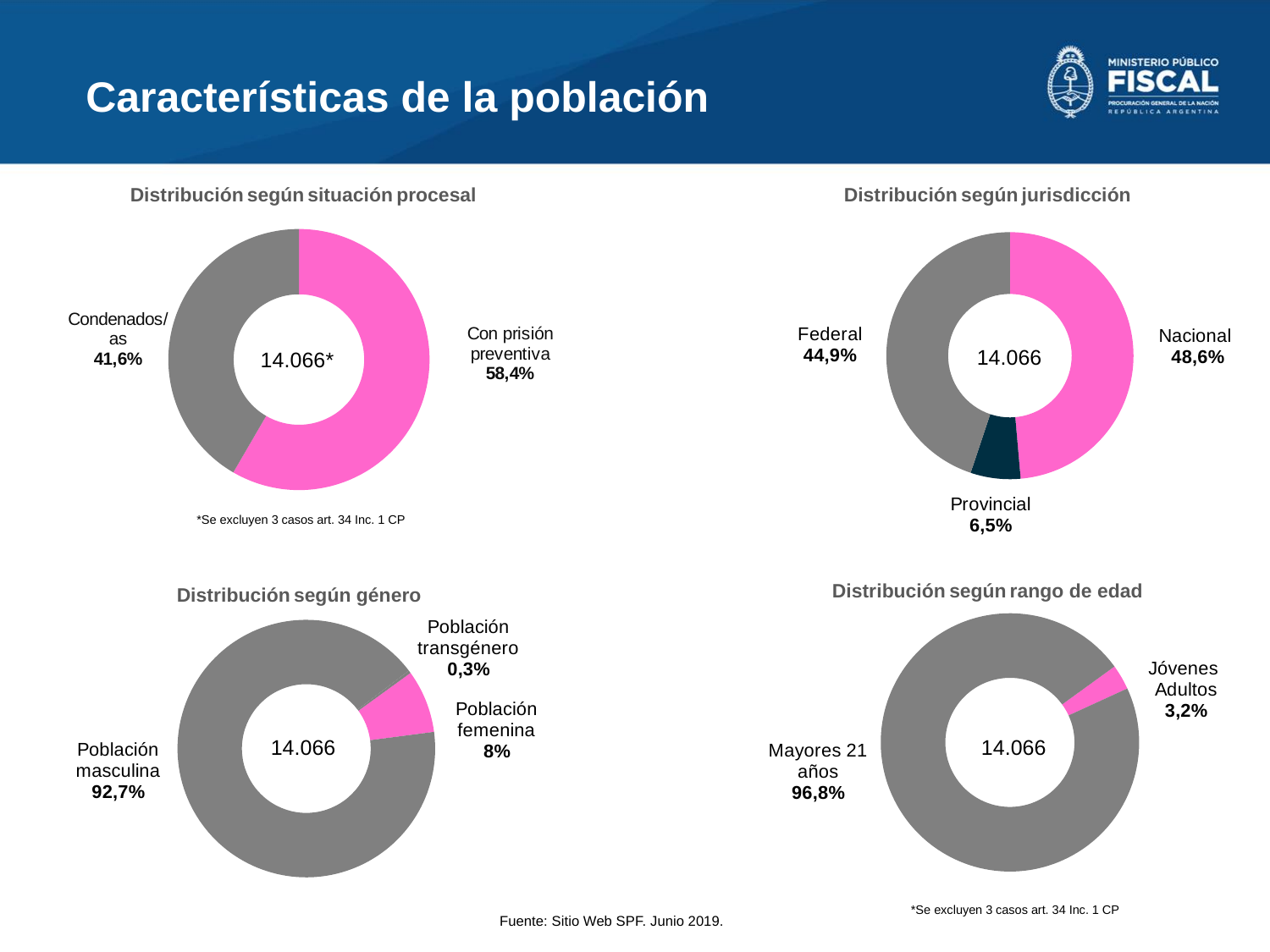
In the 'Distribución según jurisdicción' chart, what is the share for 'Federal'? 44,9% In the 'Distribución según rango de edad' chart, what share is 'Jóvenes Adultos'? 3,2% In the 'Distribución según situación procesal' chart, what share is 'Con prisión preventiva'? 58,4% In the 'Distribución según jurisdicción' chart, what is the difference in percentage points between 'Nacional' and 'Federal'? 3,7 What kind of chart is 'Distribución según género'? Doughnut (pie) chart In the 'Distribución según género' chart, what share is 'Población femenina'? 8% In the 'Distribución según rango de edad' chart, which is larger, 'Mayores 21 años' or 'Jóvenes Adultos'? Mayores 21 años In the 'Distribución según género' chart, which category has the largest share? Población masculina In the 'Distribución según jurisdicción' chart, which category has the smallest share? Provincial What total number is shown in the centre of the 'Distribución según jurisdicción' chart? 14.066 In the 'Distribución según situación procesal' chart, what share is 'Condenados/as'? 41,6% In the 'Distribución según jurisdicción' chart, how many categories are shown? 3